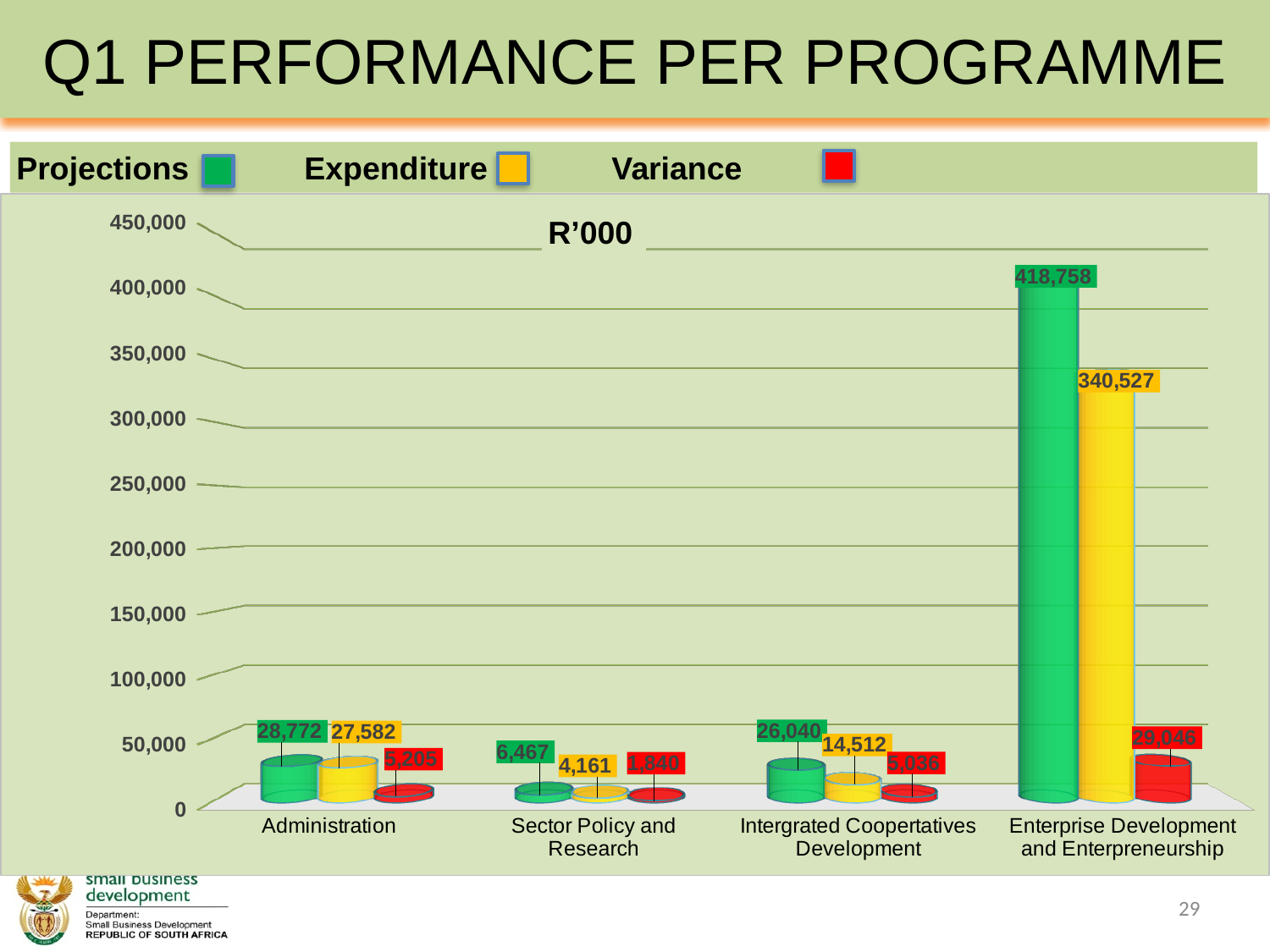
Is the Expenditure value for Enterprise Development and Enterpreneurship greater or less than 300,000? greater What is the difference between Projections and Expenditure for Enterprise Development and Enterpreneurship? 78,231 What is the Projections value for Enterprise Development and Enterpreneurship? 418,758 Which programme has the lowest Expenditure value? Sector Policy and Research How many series does the legend list? 3 Which programme has the highest Projections value? Enterprise Development and Enterpreneurship What is the Expenditure value for Administration? 27,582 What is the Expenditure value for Intergrated Coopertatives Development? 14,512 What is the Projections value for Sector Policy and Research? 6,467 How many programmes are shown on the x axis? 4 What kind of chart is shown on the slide? Bar chart Which is larger for Intergrated Coopertatives Development: Projections or Expenditure? Projections